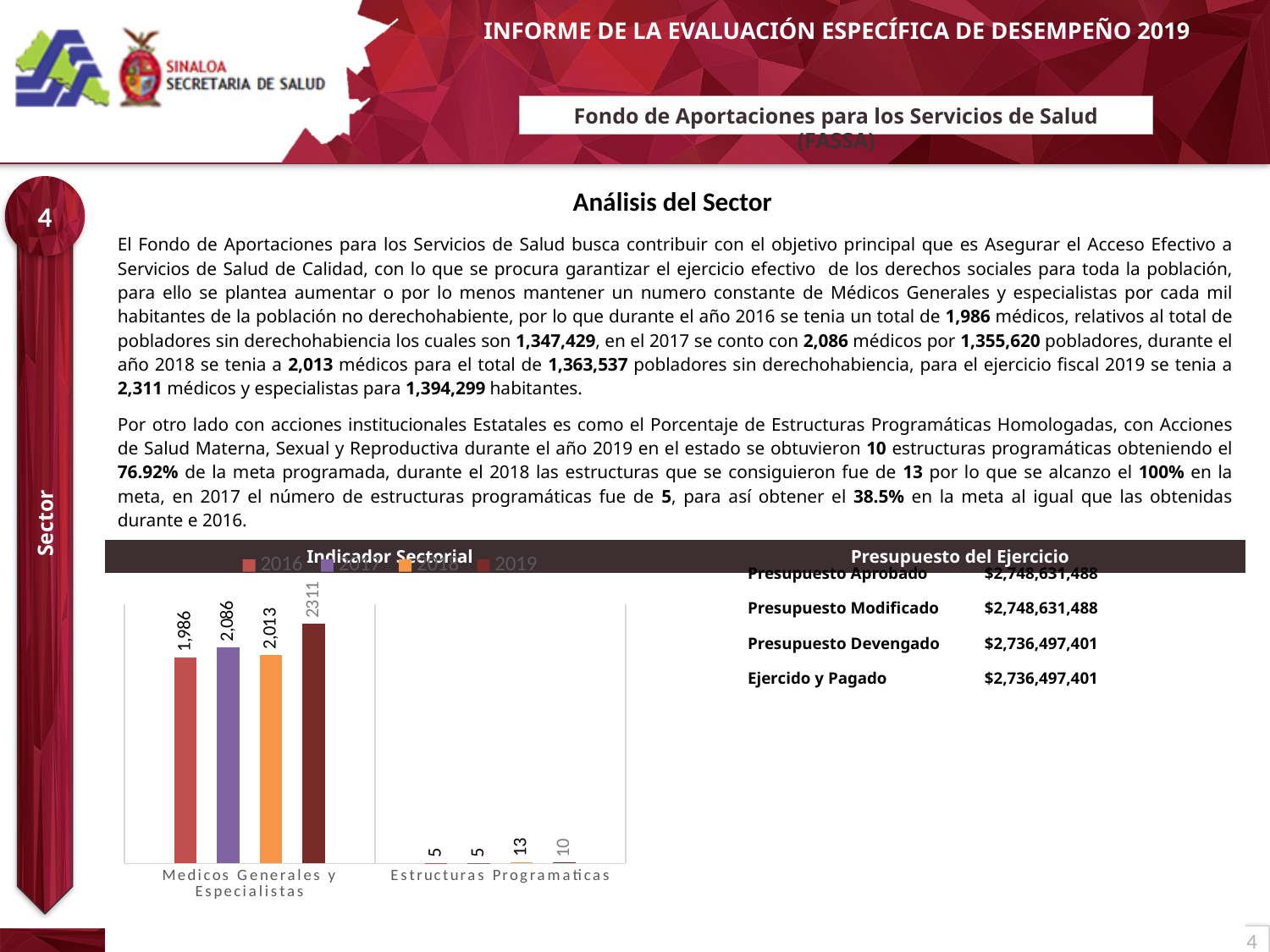
In the "Indicador Sectorial" chart, what is the value for 2018 in the "Estructuras Programaticas" category? 13 In the "Indicador Sectorial" chart, what is the value for 2016 in the "Medicos Generales y Especialistas" category? 1,986 In the "Indicador Sectorial" chart, which year has the highest value for "Medicos Generales y Especialistas"? 2019 What kind of chart is the "Indicador Sectorial" chart? bar chart In the "Indicador Sectorial" chart, what is the value for 2017 in the "Medicos Generales y Especialistas" category? 2,086 In the "Indicador Sectorial" chart, what is the value for 2019 in the "Medicos Generales y Especialistas" category? 2311 In the "Indicador Sectorial" chart, what is the value for 2018 in the "Medicos Generales y Especialistas" category? 2,013 In the "Indicador Sectorial" chart, how many categories are shown on the x axis? 2 How many series does the legend of the "Indicador Sectorial" chart list? 4 In the "Indicador Sectorial" chart, which year has the highest value for "Estructuras Programaticas"? 2018 In the "Indicador Sectorial" chart, what is the difference between the 2019 and 2016 values for "Medicos Generales y Especialistas"? 325 In the "Indicador Sectorial" chart, what is the value for 2019 in the "Estructuras Programaticas" category? 10